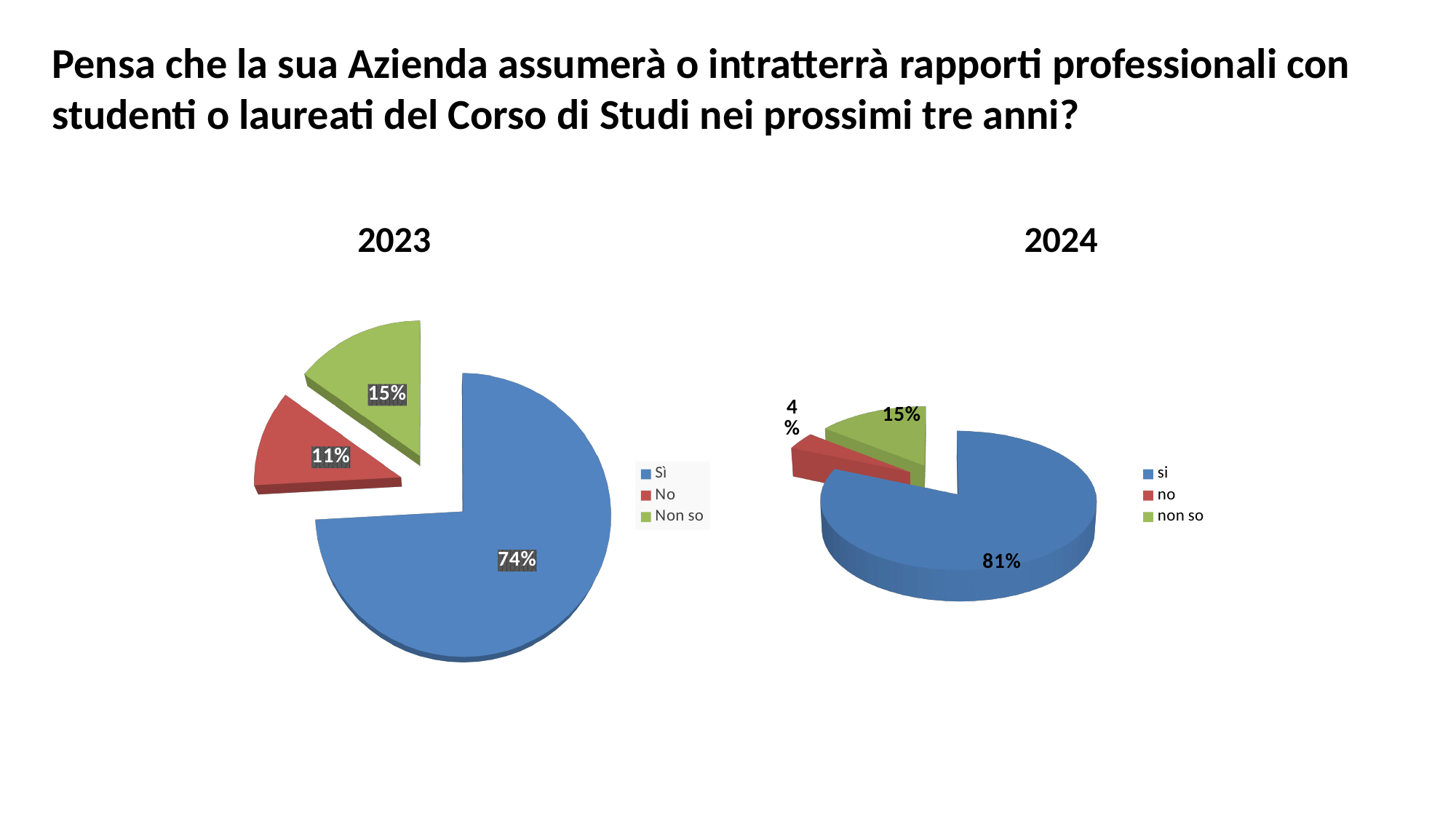
In the 2024 pie chart, what share is labelled for "non so"? 15% In the 2023 pie chart, what share is labelled for "Sì"? 74% In the 2023 pie chart, what share is labelled for "No"? 11% How many categories does the legend of the 2024 pie chart list? 3 In the 2024 pie chart, what share is labelled for "no"? 4% What is the difference between the "si" share in the 2024 chart and the "Sì" share in the 2023 chart? 7% In the 2023 pie chart, which category has the largest slice? Sì Which is larger: the "No" share in the 2023 chart or the "no" share in the 2024 chart? 2023 In the 2024 pie chart, which category has the smallest slice? no In the 2024 pie chart, what share is labelled for "si"? 81% What kind of chart is used for the 2023 data? Pie chart In the 2023 pie chart, what share is labelled for "Non so"? 15%